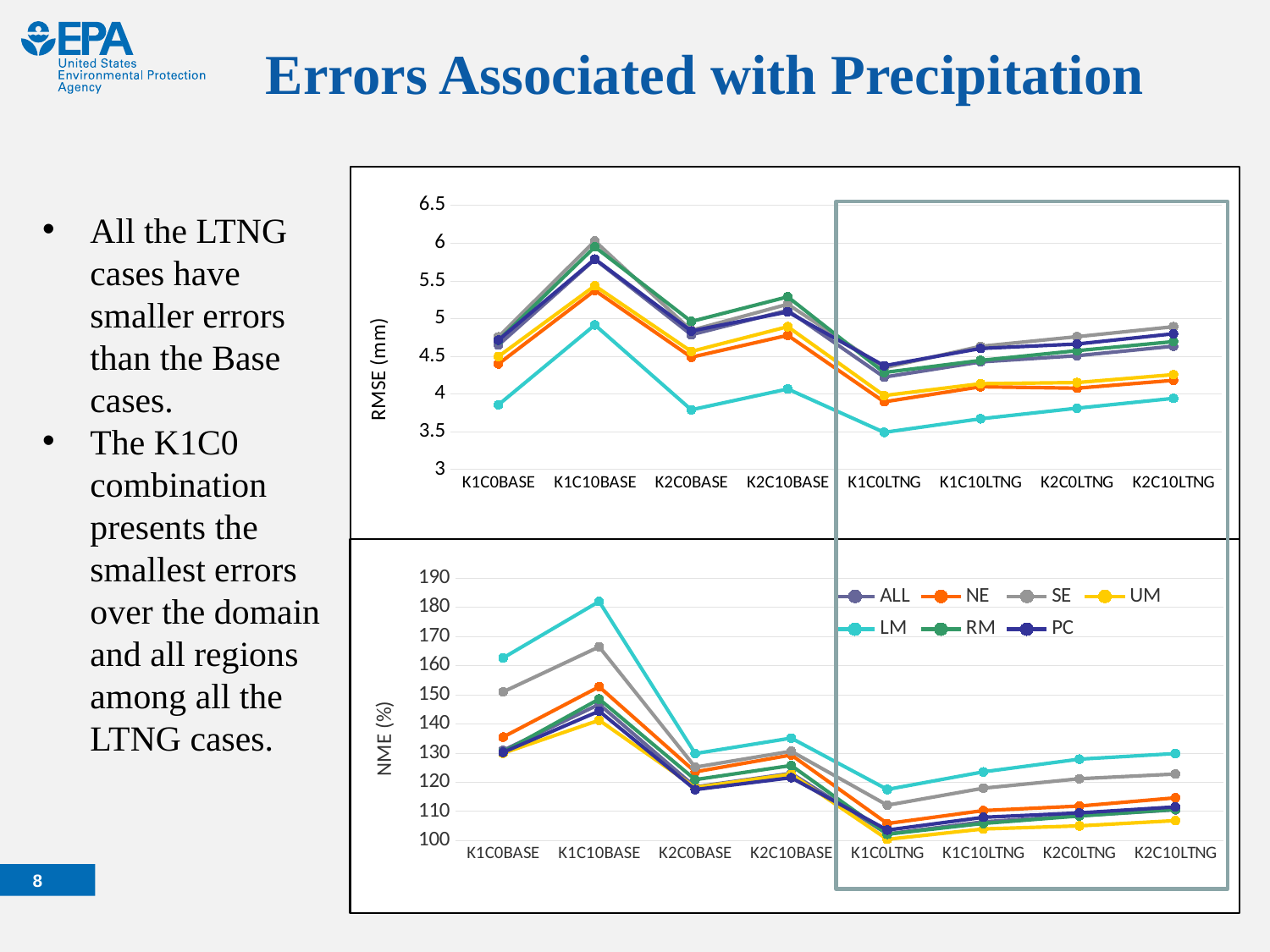
In the top chart (RMSE (mm)), is the value for SE at K1C10BASE greater or less than 5.5? greater In the top chart (RMSE (mm)), is the value for LM at K1C0LTNG greater or less than 4? less In the bottom chart (NME (%)), which series has the highest value at K1C0LTNG? LM In the bottom chart (NME (%)), which series has the highest value at K1C10BASE? LM What kind of chart is the top chart (RMSE (mm))? line chart In the top chart (RMSE (mm)), which series has the lowest values across all cases? LM In the bottom chart (NME (%)), which is larger at K1C0BASE, LM or SE? LM In the bottom chart (NME (%)), is the value for LM at K1C10BASE greater or less than 170? greater What is the y-axis label of the bottom chart? NME (%) In the top chart (RMSE (mm)), which is larger at K1C0BASE, LM or NE? NE How many categories are shown on the x axis of the bottom chart (NME (%))? 8 How many series does the legend list for the charts? 7